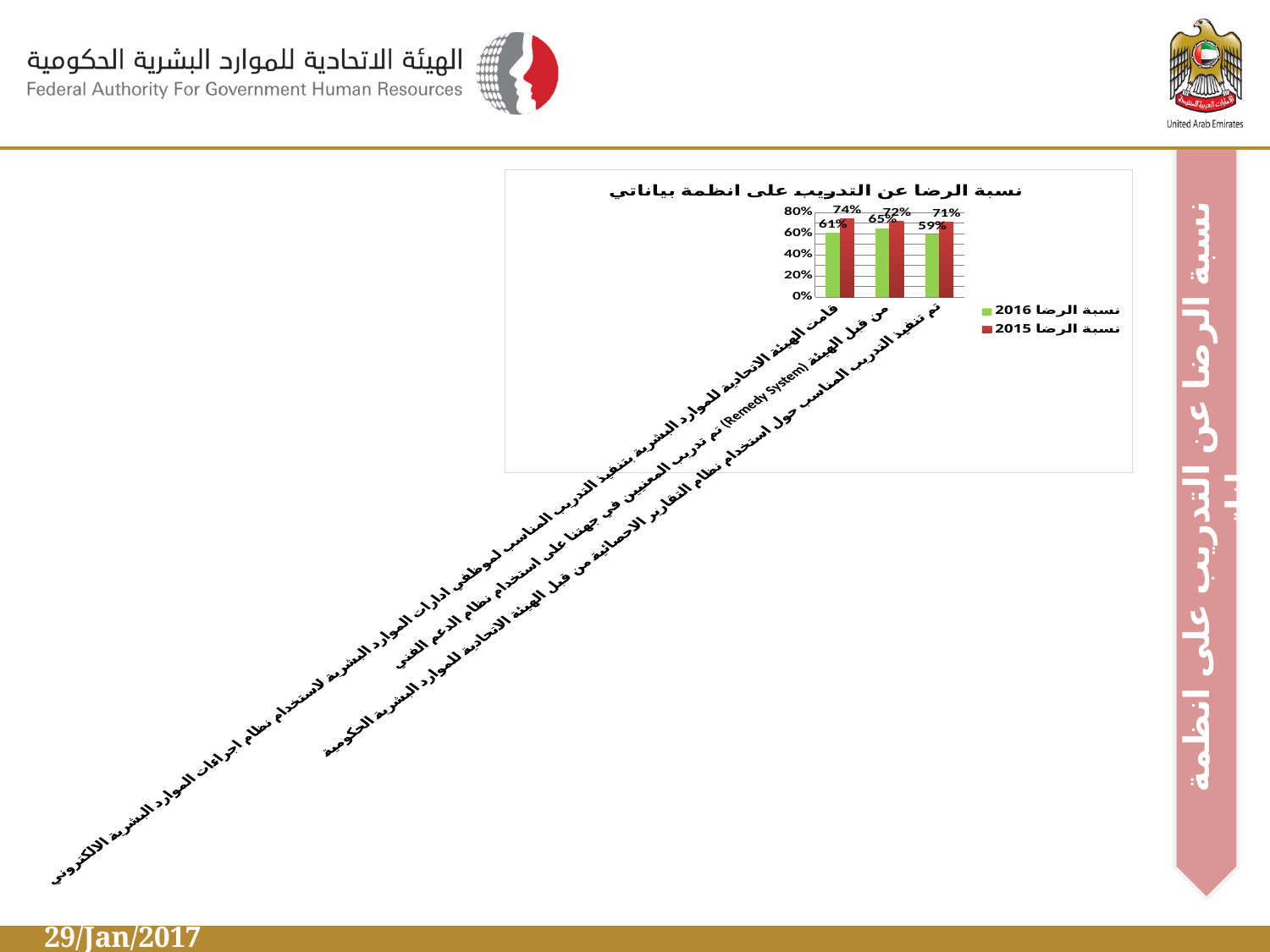
Which category has the lowest value in the نسبة الرضا 2016 series? the third (rightmost) category What is the value of the نسبة الرضا 2016 series for the second (middle) category? 65% How many series does the chart legend list? 2 What is the value of the نسبة الرضا 2015 series for the first (leftmost) category? 74% Which colour represents the نسبة الرضا 2016 series in the chart? green For the second (middle) category, which series has the larger value, نسبة الرضا 2016 or نسبة الرضا 2015? نسبة الرضا 2015 What is the difference between the نسبة الرضا 2015 and نسبة الرضا 2016 values for the first (leftmost) category? 13% What type of chart is shown on the slide? bar chart What is the value of the نسبة الرضا 2015 series for the third (rightmost) category? 71% What is the value of the نسبة الرضا 2016 series for the first (leftmost) category? 61% Which category has the highest value in the نسبة الرضا 2015 series? the first (leftmost) category How many categories are plotted on the x axis of the chart? 3